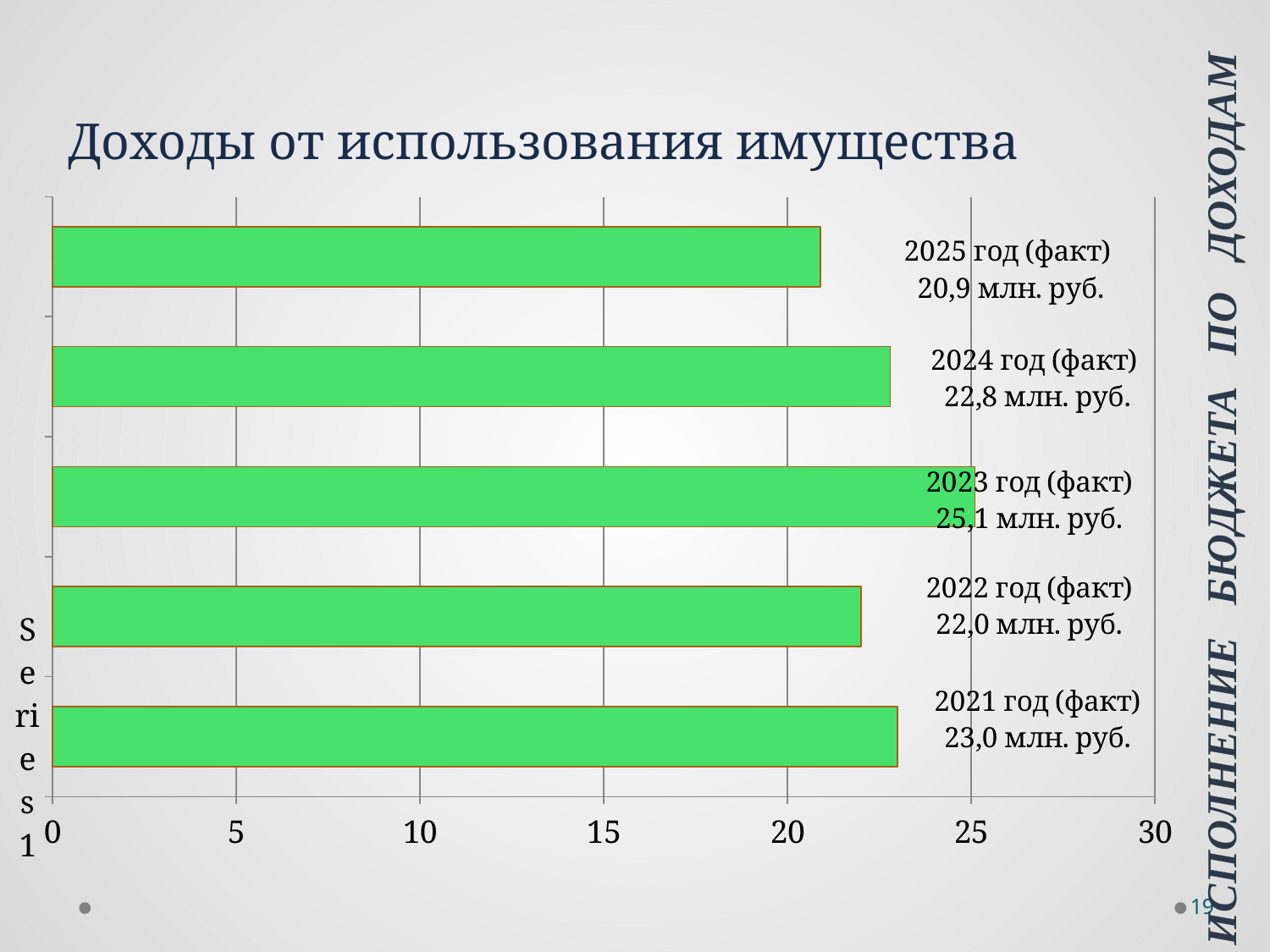
Is the value for 2023 год (факт) greater or less than 25? greater What kind of chart is shown on the slide? bar chart Which year has the highest value? 2023 год (факт) What is the value for 2025 год (факт)? 20,9 млн. руб. Which year has the lowest value? 2025 год (факт) What is the title of the chart? Доходы от использования имущества Which is larger, the value for 2024 год (факт) or 2022 год (факт)? 2024 год (факт) What is the difference between the values for 2023 год (факт) and 2025 год (факт)? 4,2 млн. руб. What is the value for 2021 год (факт)? 23,0 млн. руб. How many bars are shown in the chart? 5 What is the value for 2023 год (факт)? 25,1 млн. руб. What is the difference between the values for 2021 год (факт) and 2024 год (факт)? 0,2 млн. руб.